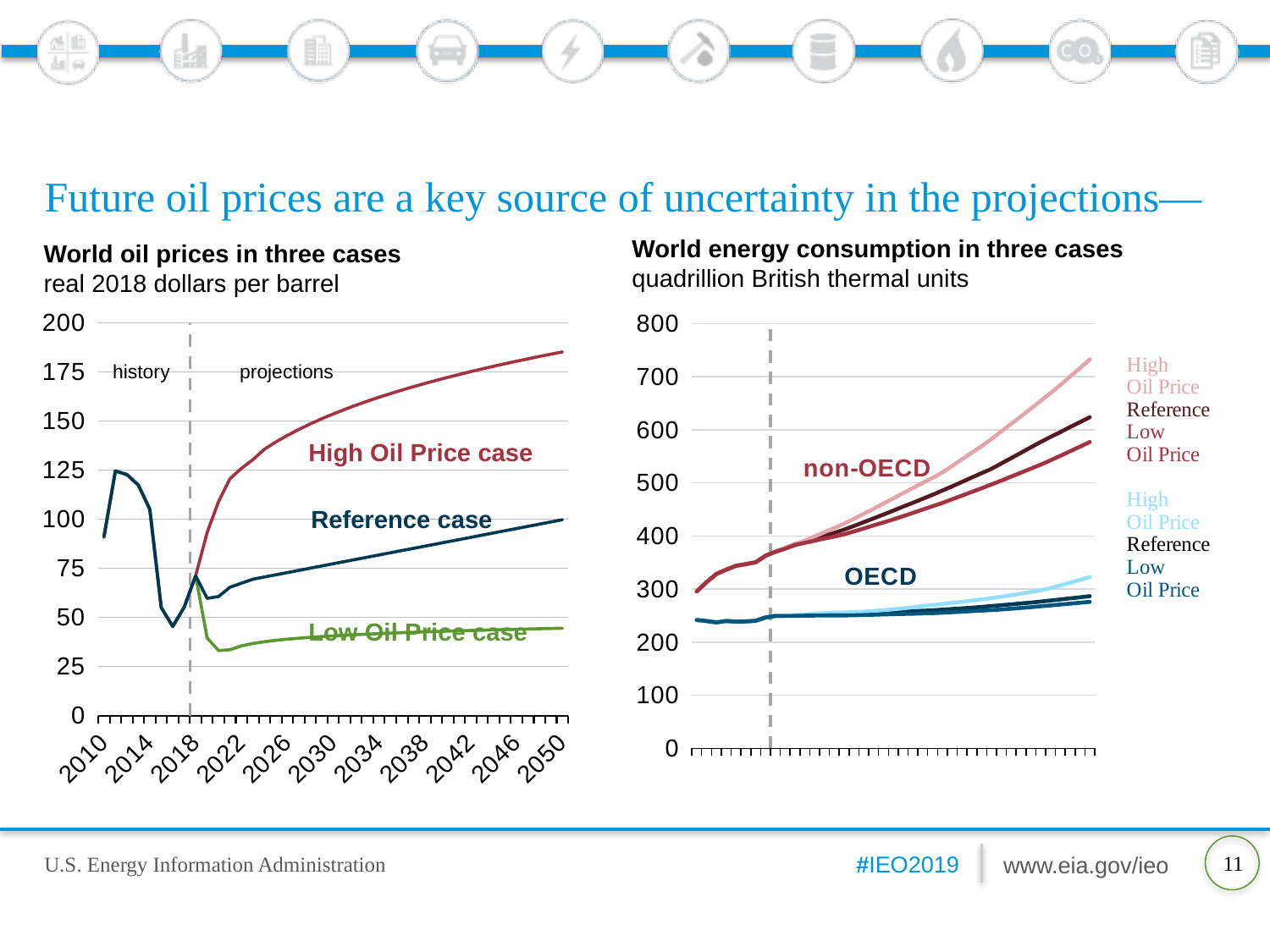
In the 'World oil prices in three cases' chart, how many cases (series) are plotted? 3 What kind of chart is the 'World energy consumption in three cases' chart? line chart What kind of chart is the 'World oil prices in three cases' chart? line chart In the 'World energy consumption in three cases' chart, is the final value of the non-OECD High Oil Price line greater or less than 700? greater In the 'World oil prices in three cases' chart, is the value for the Low Oil Price case in 2050 greater or less than 50? less What unit is used on the 'World oil prices in three cases' chart? real 2018 dollars per barrel In the 'World oil prices in three cases' chart, which case has the highest price in 2050? High Oil Price case In the 'World energy consumption in three cases' chart, how many series does the legend list? 6 In the 'World oil prices in three cases' chart, does the High Oil Price case rise or fall over the projection period after 2018? rise In the 'World energy consumption in three cases' chart, which group has higher consumption at the end of the projection, non-OECD or OECD? non-OECD In the 'World oil prices in three cases' chart, which case has the lowest price in 2050? Low Oil Price case In the 'World oil prices in three cases' chart, is the value for the High Oil Price case in 2050 greater or less than 175? greater